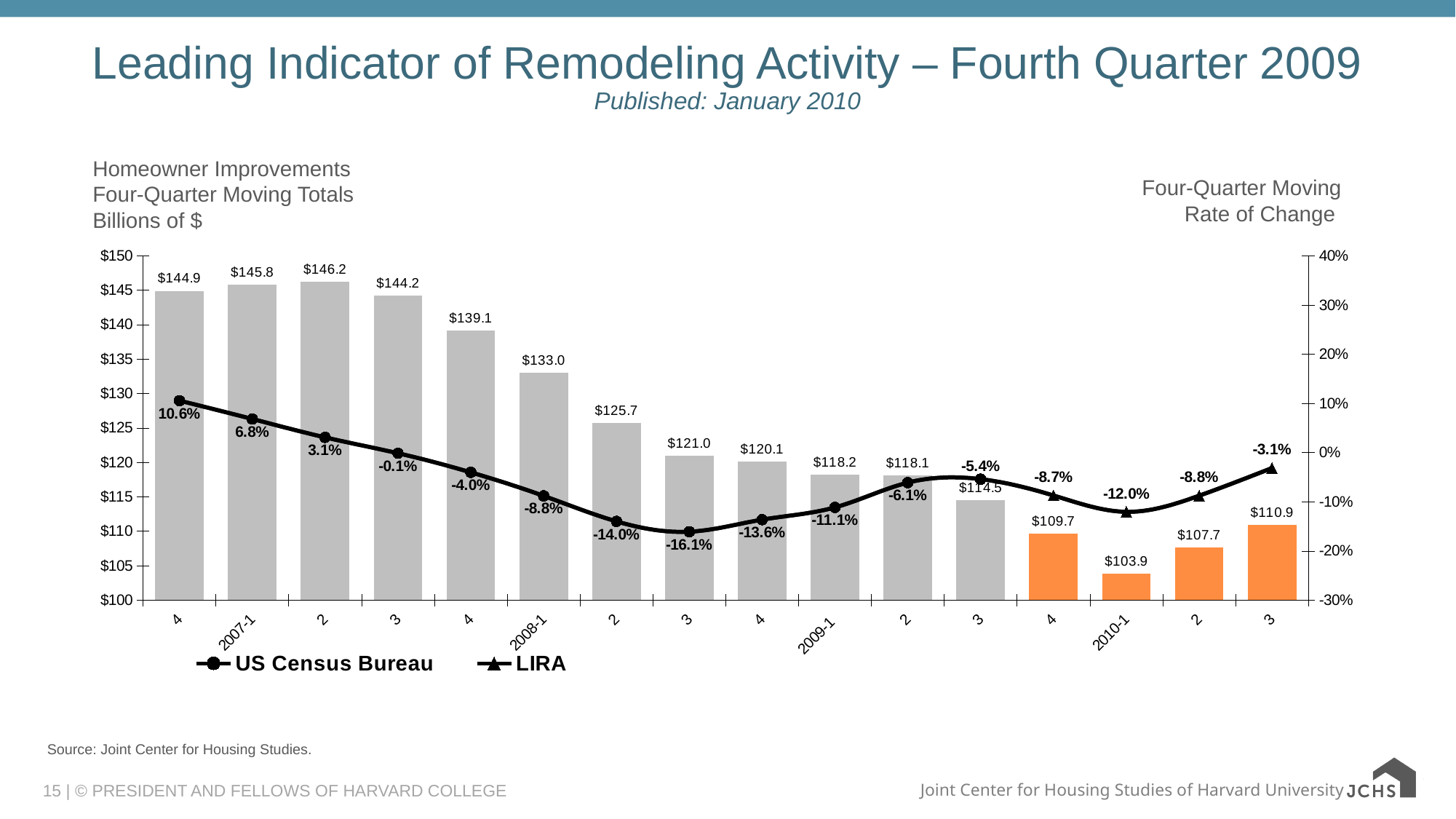
What kind of chart is shown on the slide? Combination bar and line chart How many bars (quarters) are plotted in the chart? 16 How many series does the legend list? 2 Which quarter has the lowest four-quarter moving total bar? 2010-1 ($103.9) Which is larger, the four-quarter moving total for 2008-2 or for 2008-3? 2008-2 ($125.7) Do the four-quarter moving total bars rise or fall from 2007-2 to 2010-1? Fall What is the difference between the highest bar ($146.2 in 2007-2) and the lowest bar ($103.9 in 2010-1)? $42.3 What is the LIRA four-quarter moving rate of change for 2010-1? -12.0% What is the four-quarter moving total of homeowner improvements for 2008-1? $133.0 What is the US Census Bureau four-quarter moving rate of change for 2008-3? -16.1% Which quarters are shown with orange bars instead of gray? 2009-4, 2010-1, 2010-2 and 2010-3 Which quarter has the highest four-quarter moving total bar? 2007-2 ($146.2)